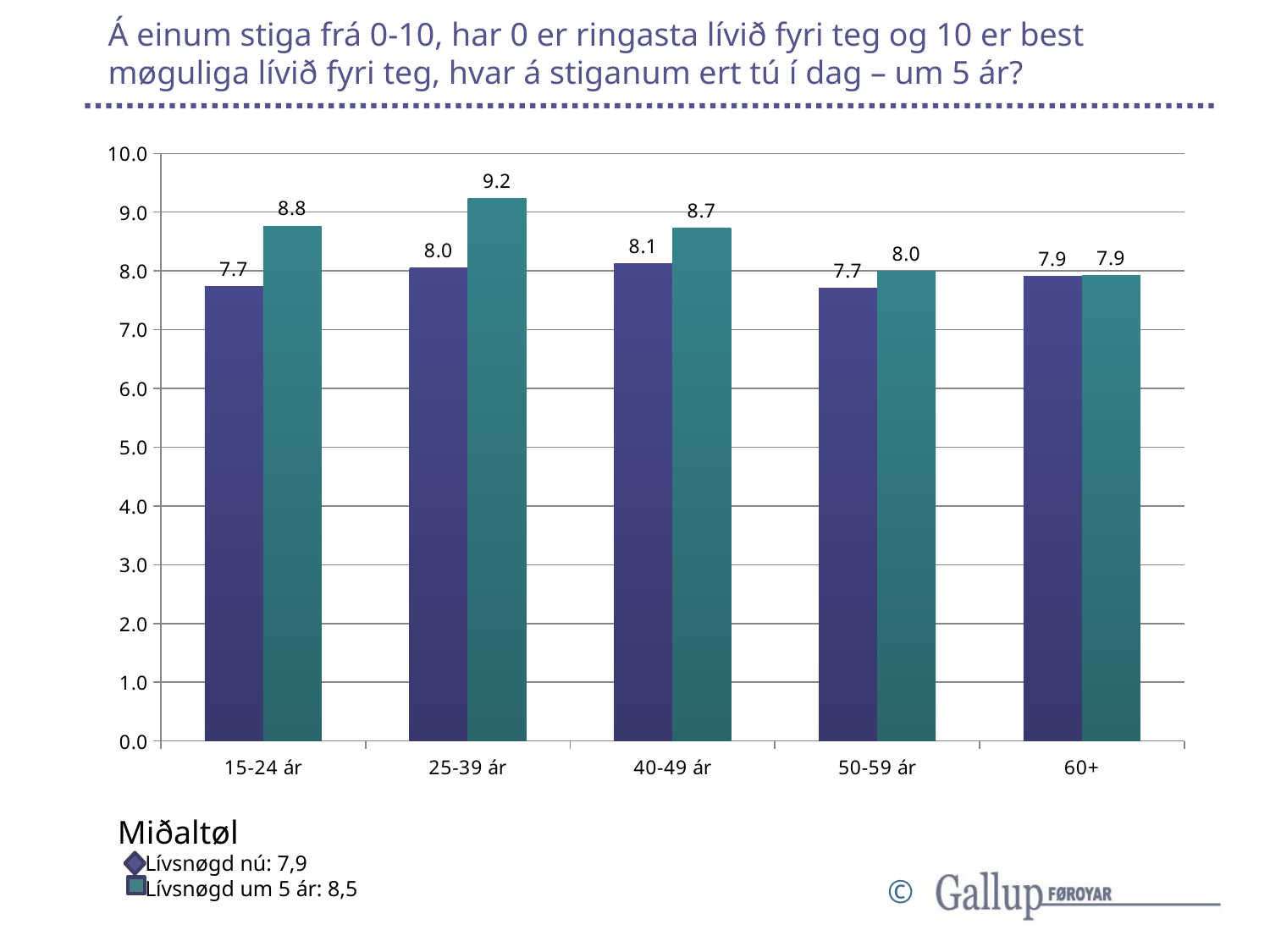
What is the value of the 'Lívsnøgd um 5 ár' series for the 60+ age group? 7.9 What is the value of the 'Lívsnøgd um 5 ár' series for the 15-24 ár age group? 8.8 According to the legend, what is the overall average (Miðaltøl) for 'Lívsnøgd um 5 ár'? 8,5 Which age group has the highest value for the 'Lívsnøgd nú' series? 40-49 ár What is the difference between the 'Lívsnøgd um 5 ár' and 'Lívsnøgd nú' values for the 25-39 ár age group? 1.2 Is the 'Lívsnøgd um 5 ár' value for the 25-39 ár age group greater or less than 9.0? greater What is the value of the 'Lívsnøgd nú' series for the 25-39 ár age group? 8.0 How many age groups are shown on the x axis of the chart? 5 For the 40-49 ár age group, which series has the larger value: 'Lívsnøgd nú' or 'Lívsnøgd um 5 ár'? Lívsnøgd um 5 ár How many series does the chart's legend list? 2 What kind of chart is shown on the slide? Bar chart Which age group has the highest value for the 'Lívsnøgd um 5 ár' series? 25-39 ár